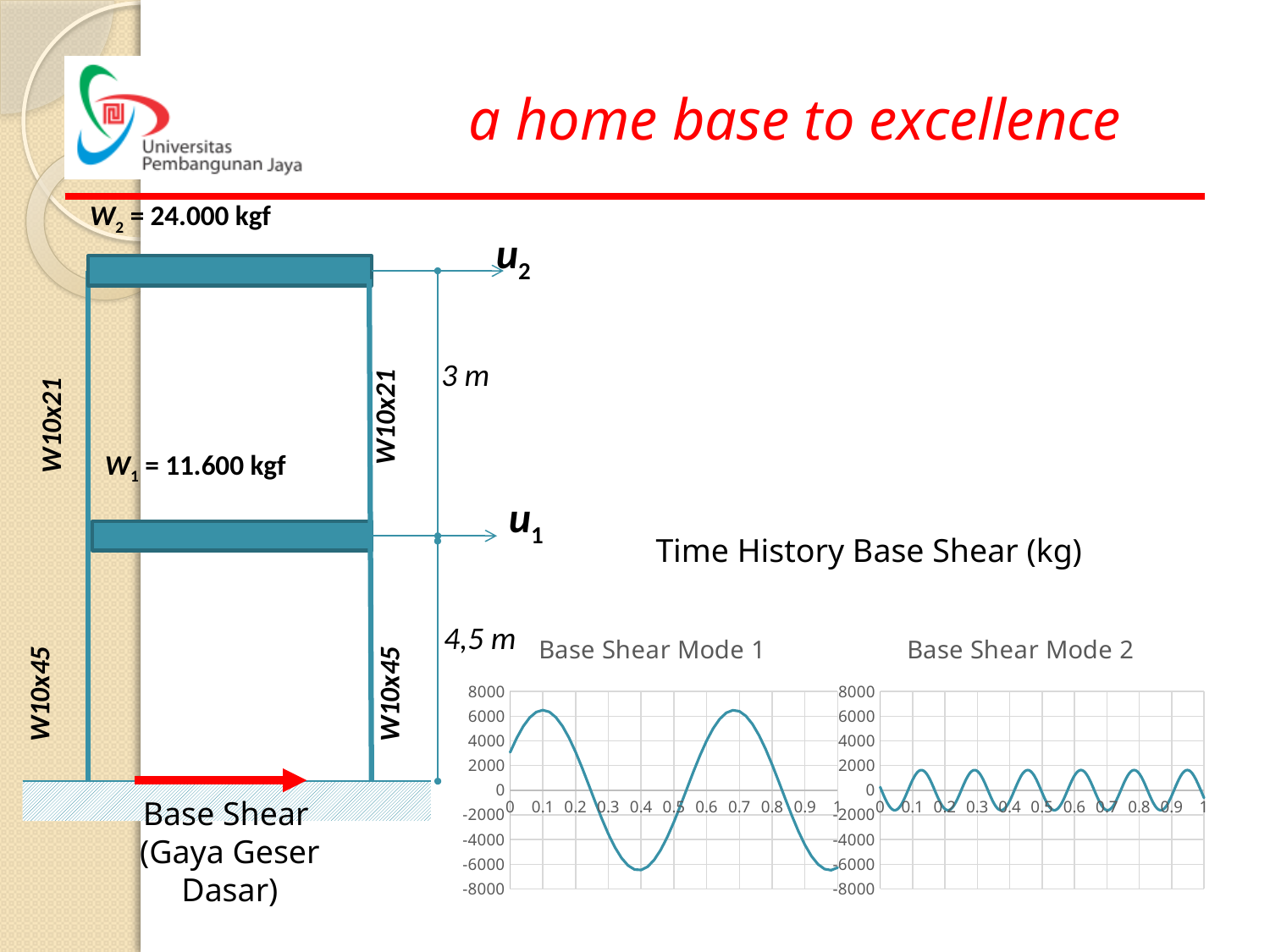
In the Base Shear Mode 1 chart, does the line rise or fall between x = 0.1 and x = 0.4? fall What kind of chart is the Base Shear Mode 2 chart? line chart Which chart reaches a higher peak value, Base Shear Mode 1 or Base Shear Mode 2? Base Shear Mode 1 In the Base Shear Mode 1 chart, is the peak value of the line greater or less than 8000? less What is the highest value shown on the vertical axis of the Base Shear Mode 2 chart? 8000 In the Base Shear Mode 1 chart, is the peak value of the line greater or less than 6000? greater In the Base Shear Mode 1 chart, does the line rise or fall between x = 0.4 and x = 0.7? rise What is the title of the right chart? Base Shear Mode 2 What is the title of the left chart? Base Shear Mode 1 In the Base Shear Mode 2 chart, is the peak value of the line greater or less than 2000? less What kind of chart is the Base Shear Mode 1 chart? line chart